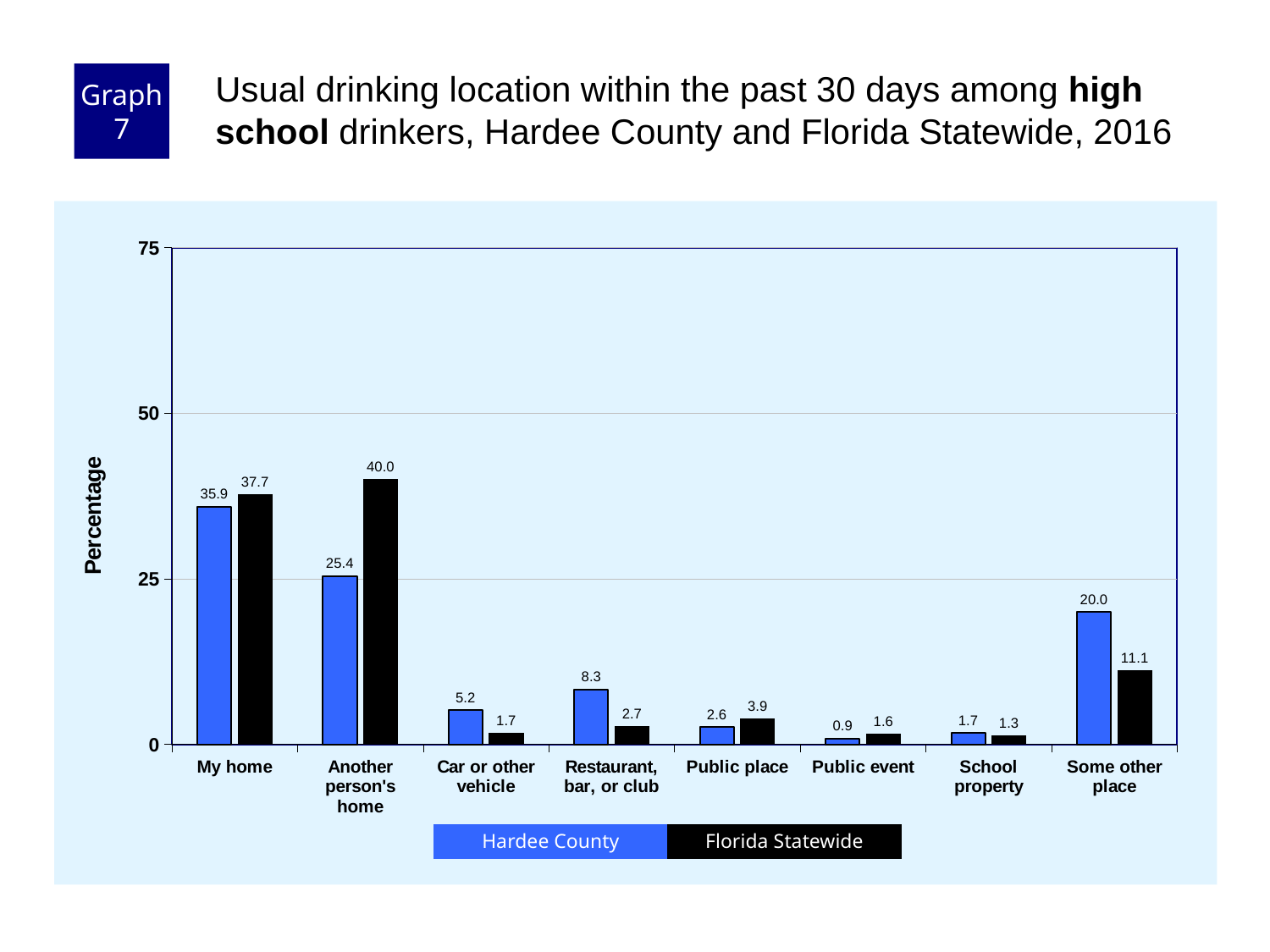
How many series does the legend list? 2 What is the label on the y axis? Percentage What is the Hardee County value for My home? 35.9 Is the Florida Statewide value for My home greater or less than 25? greater Which category has the lowest Florida Statewide value? School property What is the difference between the Florida Statewide and Hardee County values for Another person's home? 14.6 Which category has the highest Hardee County value? My home What is the Hardee County value for Some other place? 20.0 What is the Florida Statewide value for Another person's home? 40.0 Which is larger for Restaurant, bar, or club: Hardee County or Florida Statewide? Hardee County How many categories are shown on the x axis? 8 What kind of chart is shown? bar chart